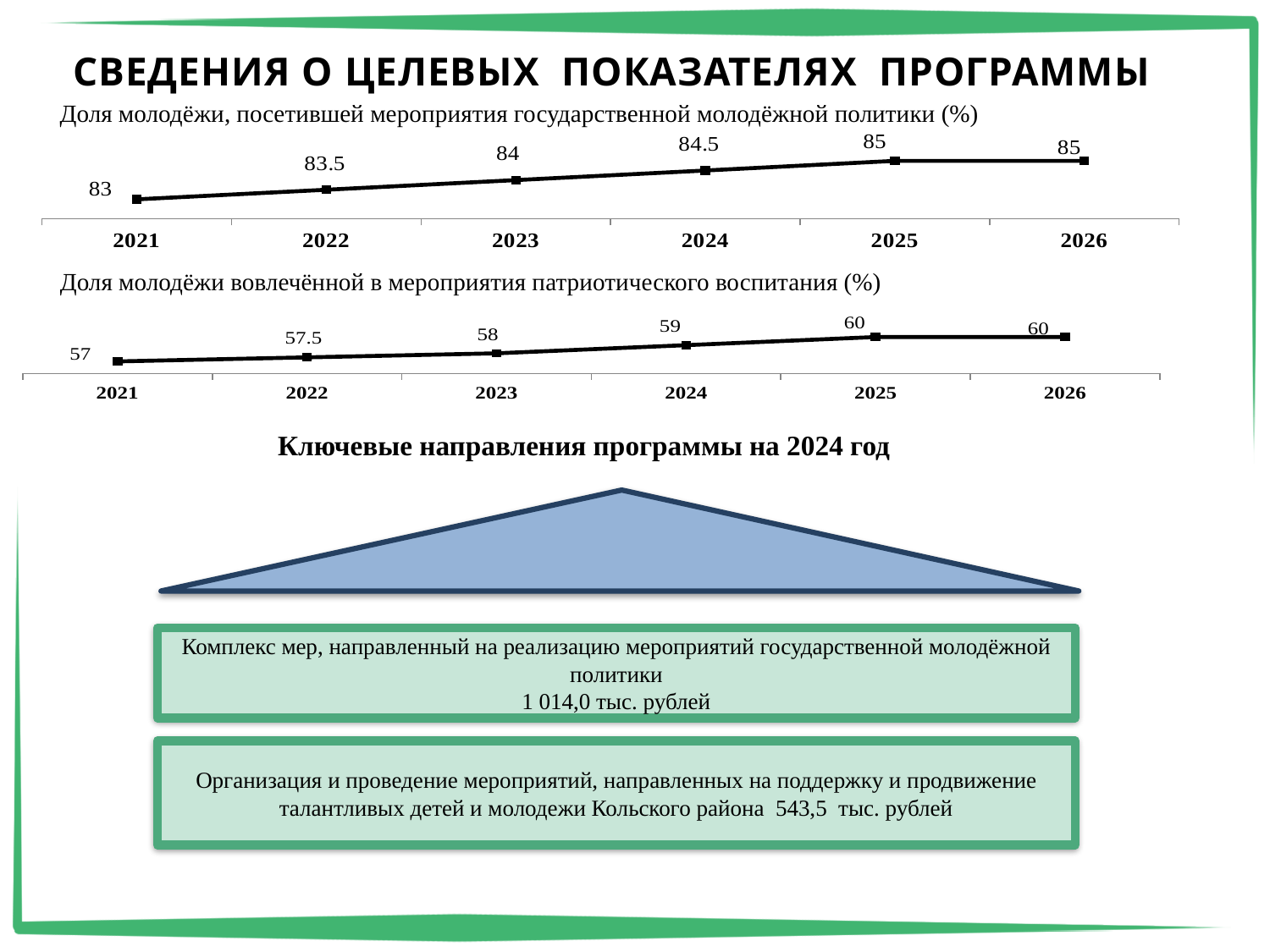
In the top chart (Доля молодёжи, посетившей мероприятия государственной молодёжной политики), what is the value for 2024? 84.5 How many data points are plotted in the top chart (Доля молодёжи, посетившей мероприятия государственной молодёжной политики)? 6 In the bottom chart (Доля молодёжи вовлечённой в мероприятия патриотического воспитания), which is larger: the value for 2022 or the value for 2024? 2024 What type of chart is the bottom chart (Доля молодёжи вовлечённой в мероприятия патриотического воспитания)? Line chart In the bottom chart (Доля молодёжи вовлечённой в мероприятия патриотического воспитания), what is the value for 2023? 58 In the top chart (Доля молодёжи, посетившей мероприятия государственной молодёжной политики), do the values rise or fall from 2021 to 2025? Rise In the top chart (Доля молодёжи, посетившей мероприятия государственной молодёжной политики), what is the value for 2021? 83 In the bottom chart (Доля молодёжи вовлечённой в мероприятия патриотического воспитания), which year has the lowest value? 2021 In the top chart (Доля молодёжи, посетившей мероприятия государственной молодёжной политики), which year has the lowest value? 2021 In the bottom chart (Доля молодёжи вовлечённой в мероприятия патриотического воспитания), what is the value for 2026? 60 In the bottom chart (Доля молодёжи вовлечённой в мероприятия патриотического воспитания), what is the difference between the 2025 value and the 2022 value? 2.5 In the top chart (Доля молодёжи, посетившей мероприятия государственной молодёжной политики), what is the difference between the 2026 value and the 2021 value? 2